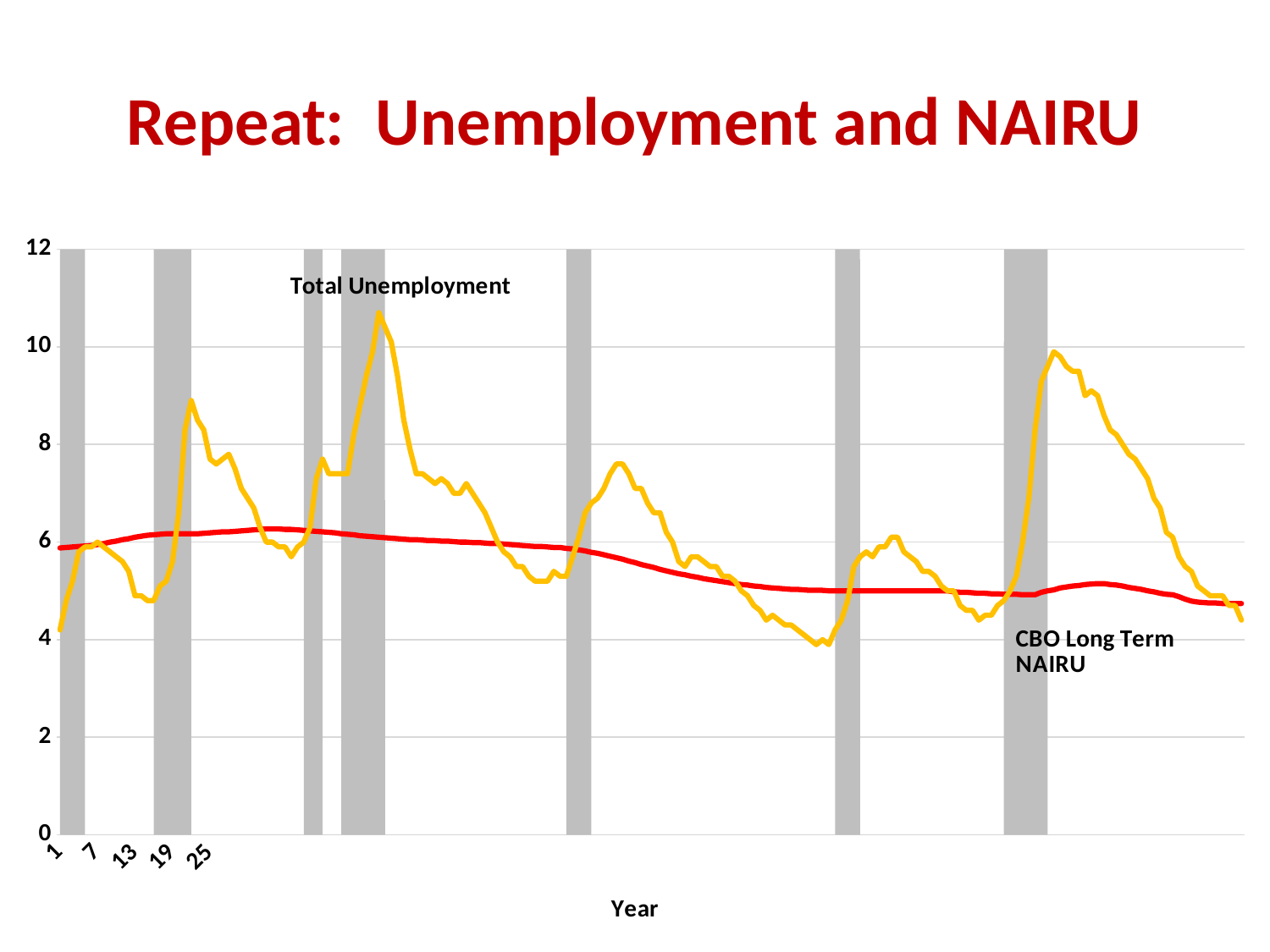
Is the value of CBO Long Term NAIRU at the right end of the chart greater or less than 6? less Is the lowest value of Total Unemployment greater or less than 6? less What colour is the Total Unemployment line? Yellow How many data series are plotted on the chart? 3 What is the title of the slide? Repeat: Unemployment and NAIRU At the highest peak of Total Unemployment, which series is higher, Total Unemployment or CBO Long Term NAIRU? Total Unemployment Is the highest value of Total Unemployment greater or less than 10? greater At year 1, which series has the higher value, Total Unemployment or CBO Long Term NAIRU? CBO Long Term NAIRU Does the CBO Long Term NAIRU line generally rise or fall from the left of the chart to the right? Fall Which series reaches the higher maximum value, Total Unemployment or CBO Long Term NAIRU? Total Unemployment What kind of chart is shown on the slide? Line chart